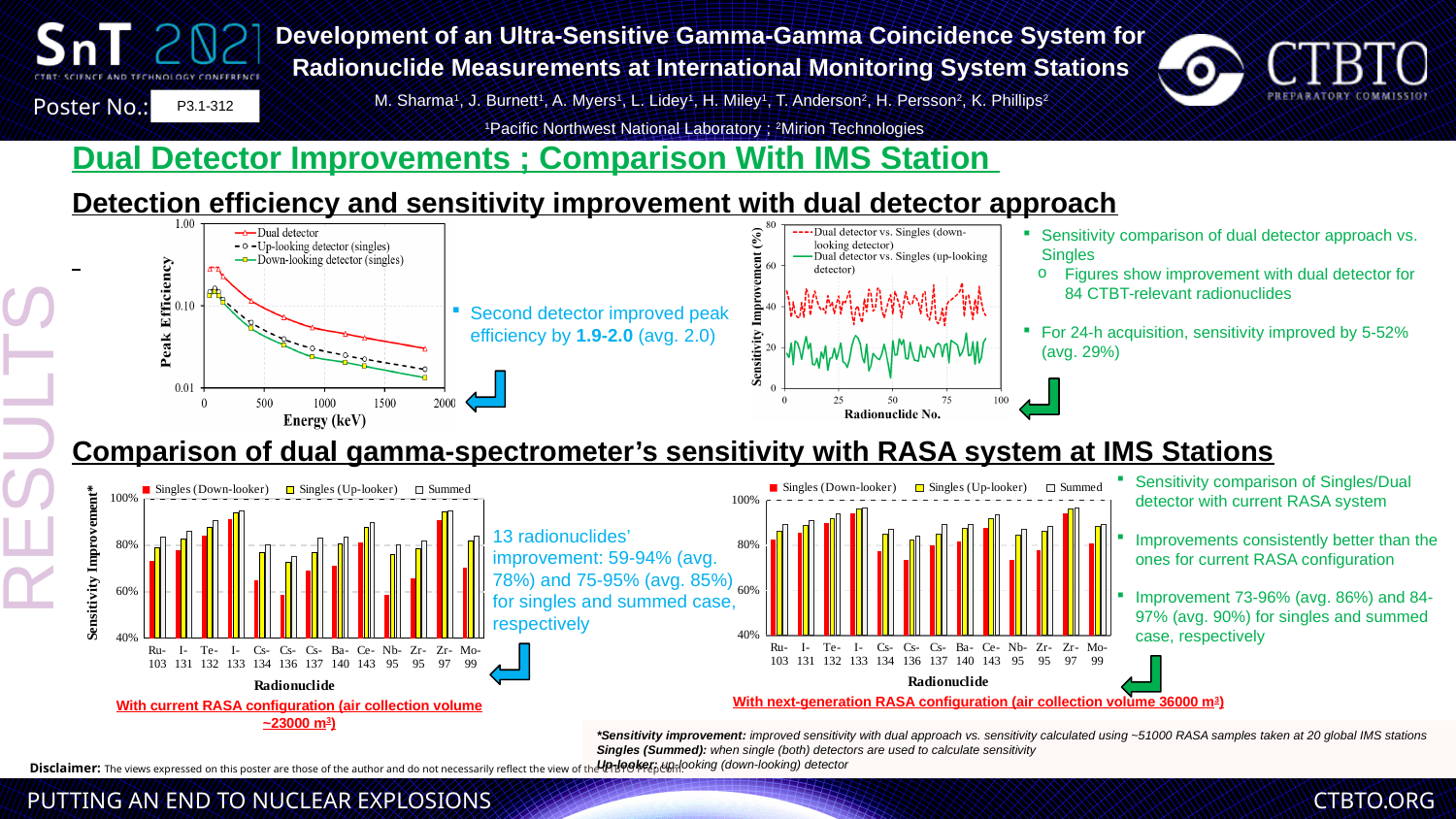
On the bottom-left bar chart (current RASA configuration), how many radionuclides are shown on the x axis? 13 On the top-left chart of Peak Efficiency versus Energy (keV), at around 500 keV, which is larger: the Dual detector value or the Down-looking detector (singles) value? Dual detector On the top-left chart of Peak Efficiency versus Energy (keV), what kind of chart is it? line chart On the bottom-left bar chart (current RASA configuration), how many series does the legend list? 3 On the top-left chart of Peak Efficiency versus Energy (keV), does peak efficiency rise or fall as energy increases? fall On the top-right chart of Sensitivity Improvement (%) versus Radionuclide No., how many series does the legend list? 2 On the bottom-left bar chart (current RASA configuration), is the Summed value for Zr-97 greater or less than 80%? greater On the bottom-left bar chart (current RASA configuration), which is larger for Singles (Down-looker): Zr-97 or Cs-136? Zr-97 On the top-left chart of Peak Efficiency versus Energy (keV), which series is drawn in red? Dual detector On the bottom-right bar chart (next-generation RASA configuration), is the Singles (Down-looker) value for Cs-136 greater or less than 80%? less On the top-right chart of Sensitivity Improvement (%) versus Radionuclide No., which series generally has the higher values: the down-looking comparison or the up-looking comparison? Dual detector vs. Singles (down-looking detector) On the top-left chart of Peak Efficiency versus Energy (keV), how many series does the legend list? 3